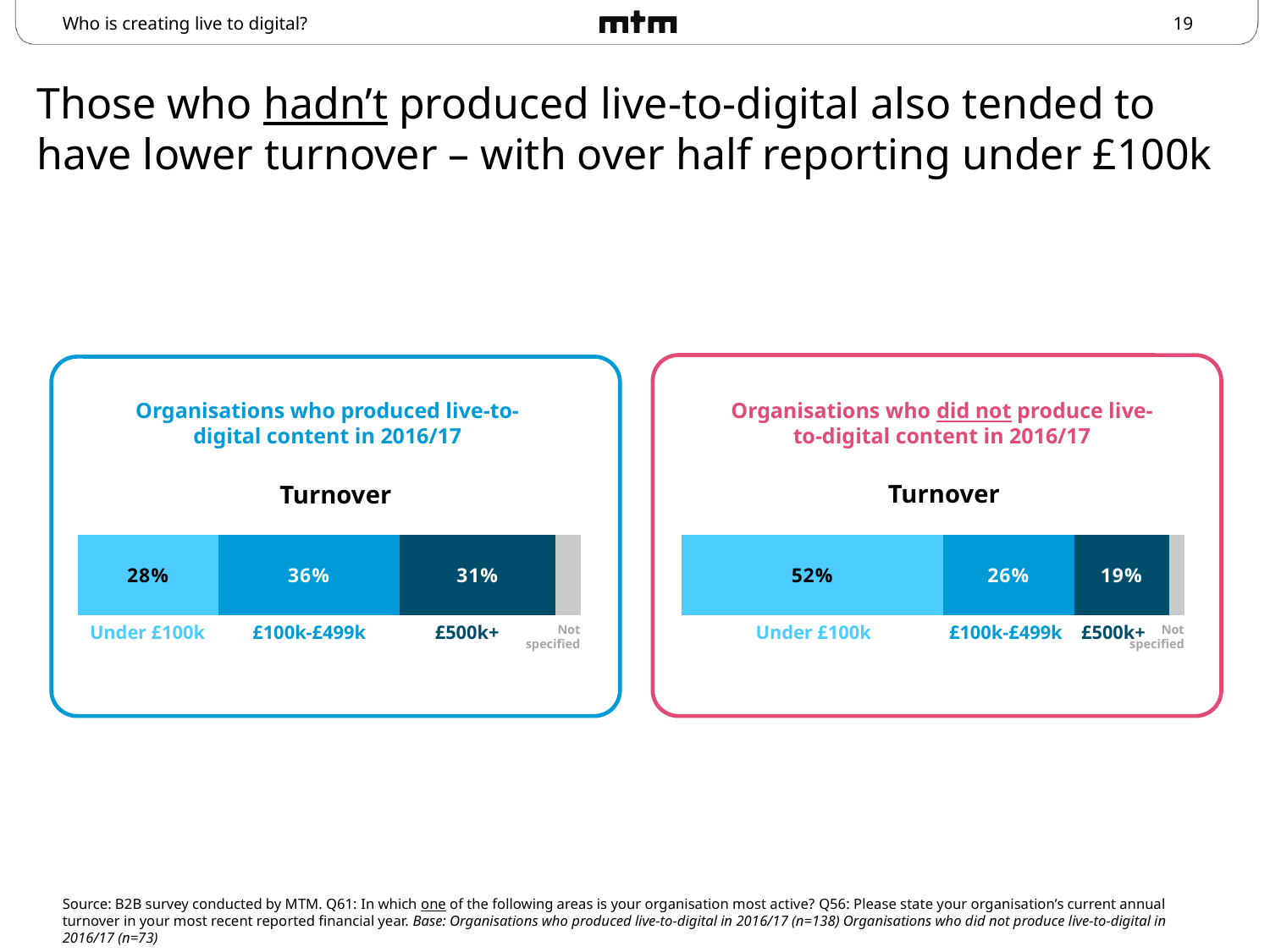
In the chart for organisations who did not produce live-to-digital content in 2016/17, which turnover band has the largest share? Under £100k In the chart for organisations who produced live-to-digital content in 2016/17, what share reported turnover under £100k? 28% How many turnover segments, including Not specified, are shown in the bar for organisations who produced live-to-digital content in 2016/17? 4 What is the difference between the Under £100k share for organisations who did not produce live-to-digital content and the Under £100k share for organisations who produced it? 24 percentage points In the chart for organisations who did not produce live-to-digital content in 2016/17, what share reported turnover under £100k? 52% In the chart for organisations who did not produce live-to-digital content in 2016/17, what share reported turnover of £500k+? 19% In the chart for organisations who produced live-to-digital content in 2016/17, which labelled turnover band has the largest share? £100k-£499k In the chart for organisations who produced live-to-digital content in 2016/17, what share reported turnover of £100k-£499k? 36% In the chart for organisations who did not produce live-to-digital content in 2016/17, which labelled turnover band has the smallest share? £500k+ What kind of chart is used in the box for organisations who did not produce live-to-digital content in 2016/17? Stacked bar chart In the chart for organisations who produced live-to-digital content in 2016/17, what share reported turnover of £500k+? 31% Which is larger: the £500k+ share for organisations who produced live-to-digital content, or the £500k+ share for organisations who did not? Organisations who produced live-to-digital content (31%)